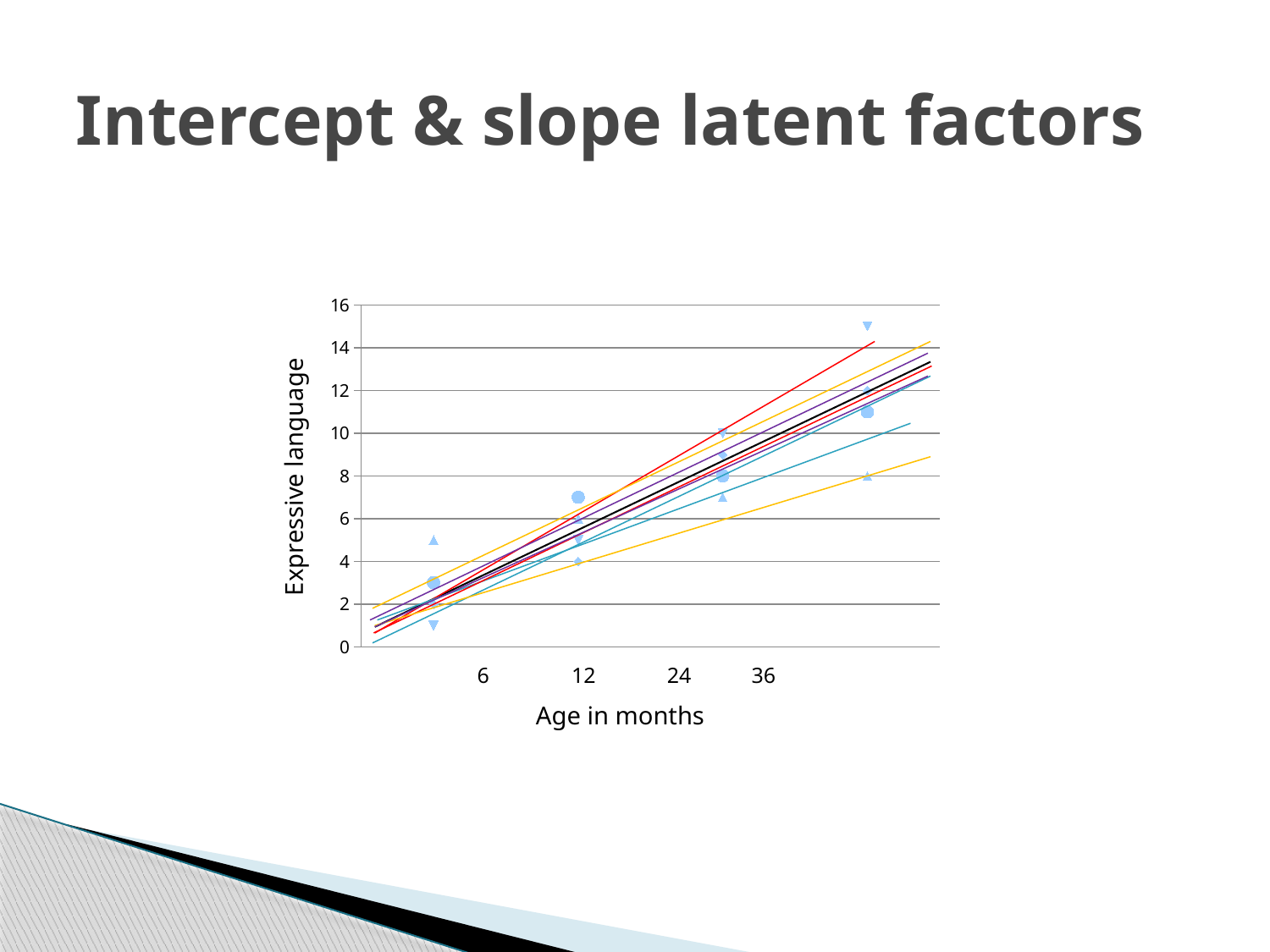
What is the label on the y axis of the chart? Expressive language Is the highest plotted point in the chart greater or less than 14? greater How many age values are labelled on the x axis of the chart? 4 What is the title of the slide containing the chart? Intercept & slope latent factors Is the lowest plotted point in the chart greater or less than 2? less What is the label on the x axis of the chart? Age in months Do the fitted lines in the chart rise or fall as age in months increases? rise